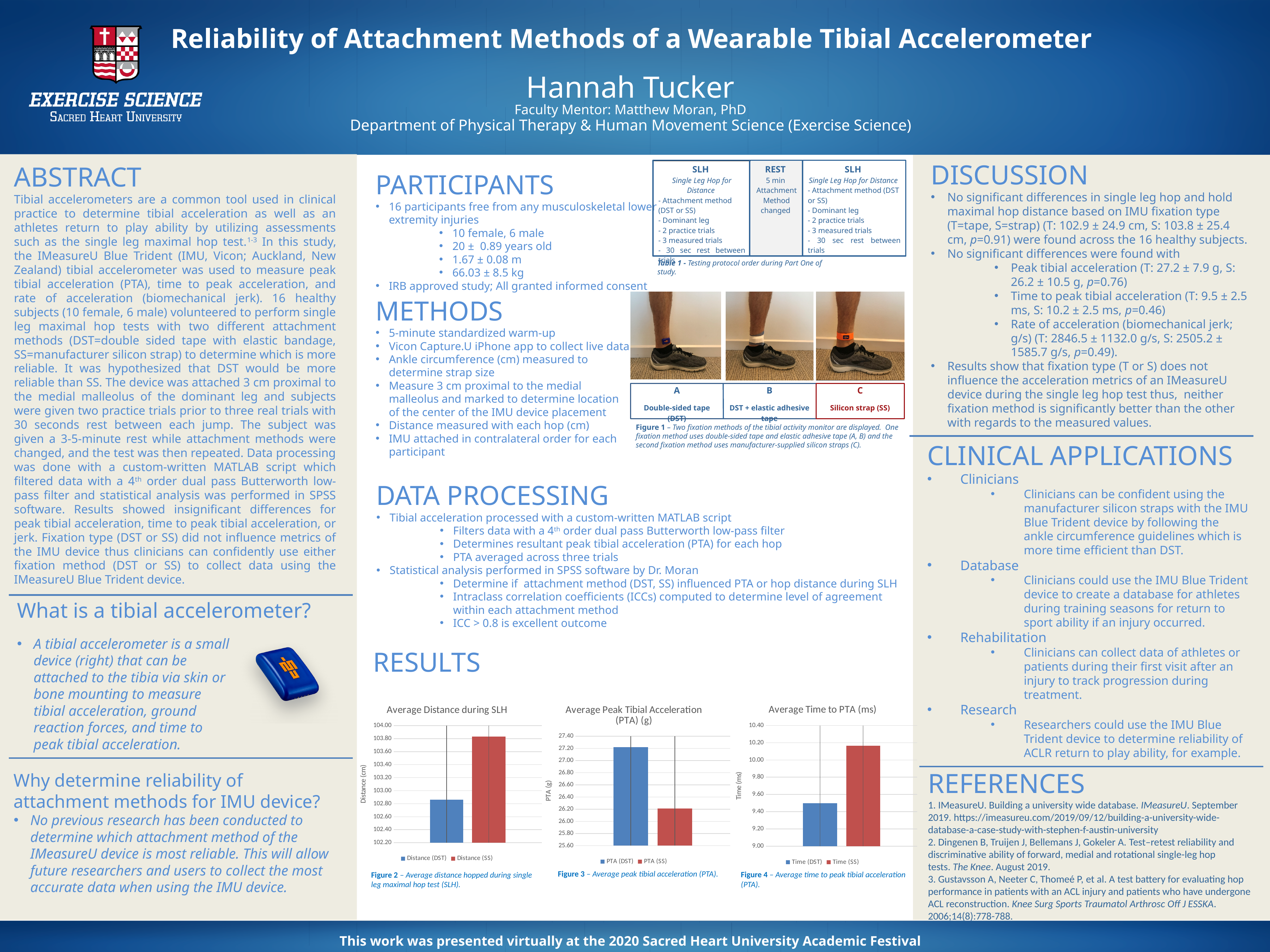
What is the y-axis label of the "Average Distance during SLH" chart? Distance (cm) In the "Average Distance during SLH" chart, which is larger, Distance (DST) or Distance (SS)? Distance (SS) How many bars are plotted in the "Average Time to PTA (ms)" chart? 2 In the "Average Distance during SLH" chart, is the value for Distance (DST) greater or less than 103.00? less In the "Average Time to PTA (ms)" chart, is the value for Time (SS) greater or less than 10.00? greater How many series does the legend of the "Average Peak Tibial Acceleration (PTA) (g)" chart list? 2 In the "Average Peak Tibial Acceleration (PTA) (g)" chart, is the value for PTA (SS) greater or less than 26.40? less In the "Average Time to PTA (ms)" chart, which is larger, Time (DST) or Time (SS)? Time (SS) What kind of chart is the "Average Distance during SLH" chart? bar chart In the "Average Peak Tibial Acceleration (PTA) (g)" chart, which is larger, PTA (DST) or PTA (SS)? PTA (DST)